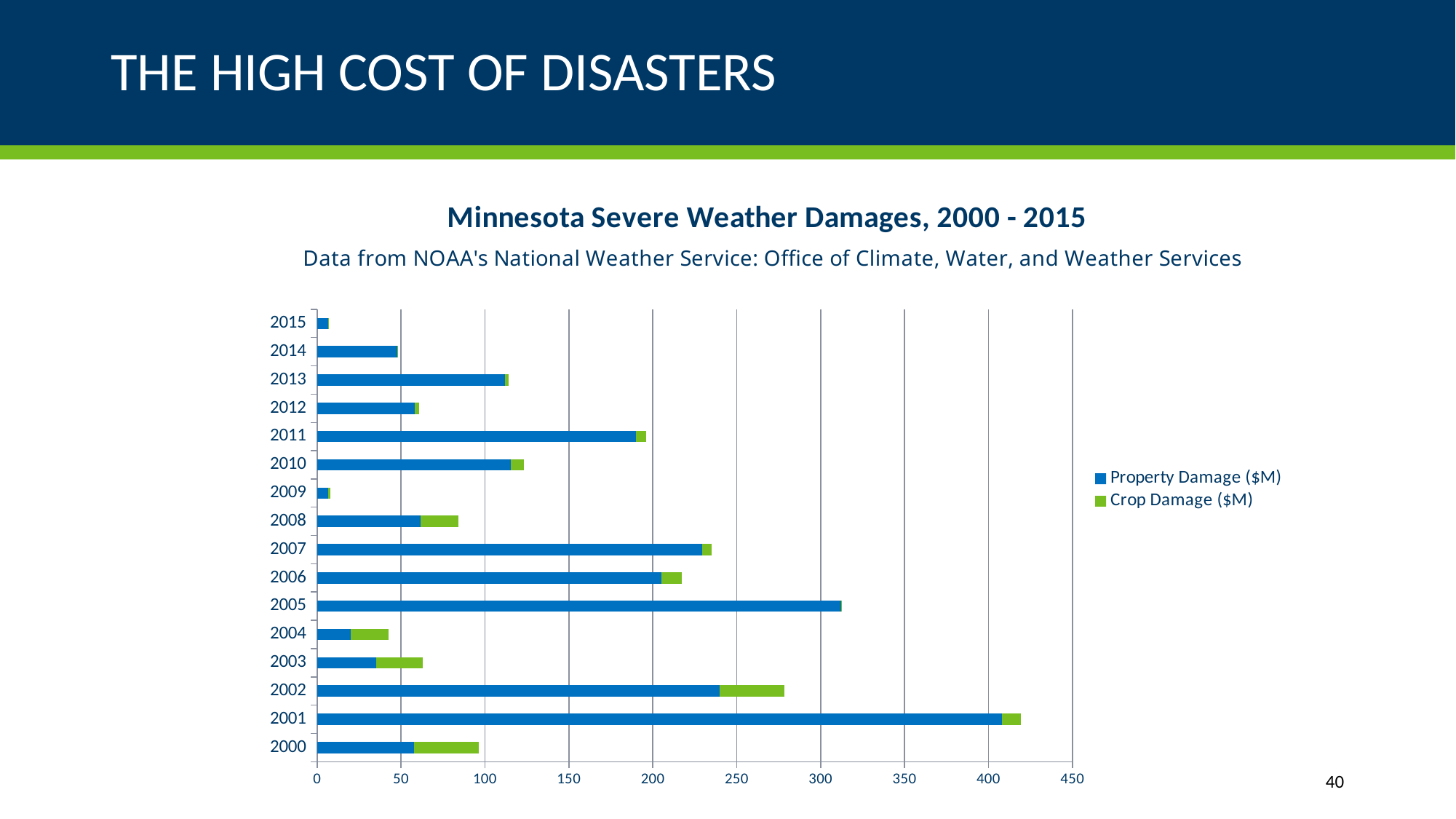
Which series is shown in green? Crop Damage ($M) Is the total damage for 2005 greater or less than 300? greater Is the Property Damage ($M) for 2000 greater or less than 100? less How many years are plotted on the chart? 16 Which year has the highest total severe weather damages? 2001 Which year has the larger total damage, 2000 or 2004? 2000 Which year has the larger total damage, 2005 or 2007? 2005 Which year has the highest Property Damage ($M)? 2001 Is the total damage for 2002 greater or less than 250? greater What kind of chart is shown on the slide? bar chart How many series does the legend list? 2